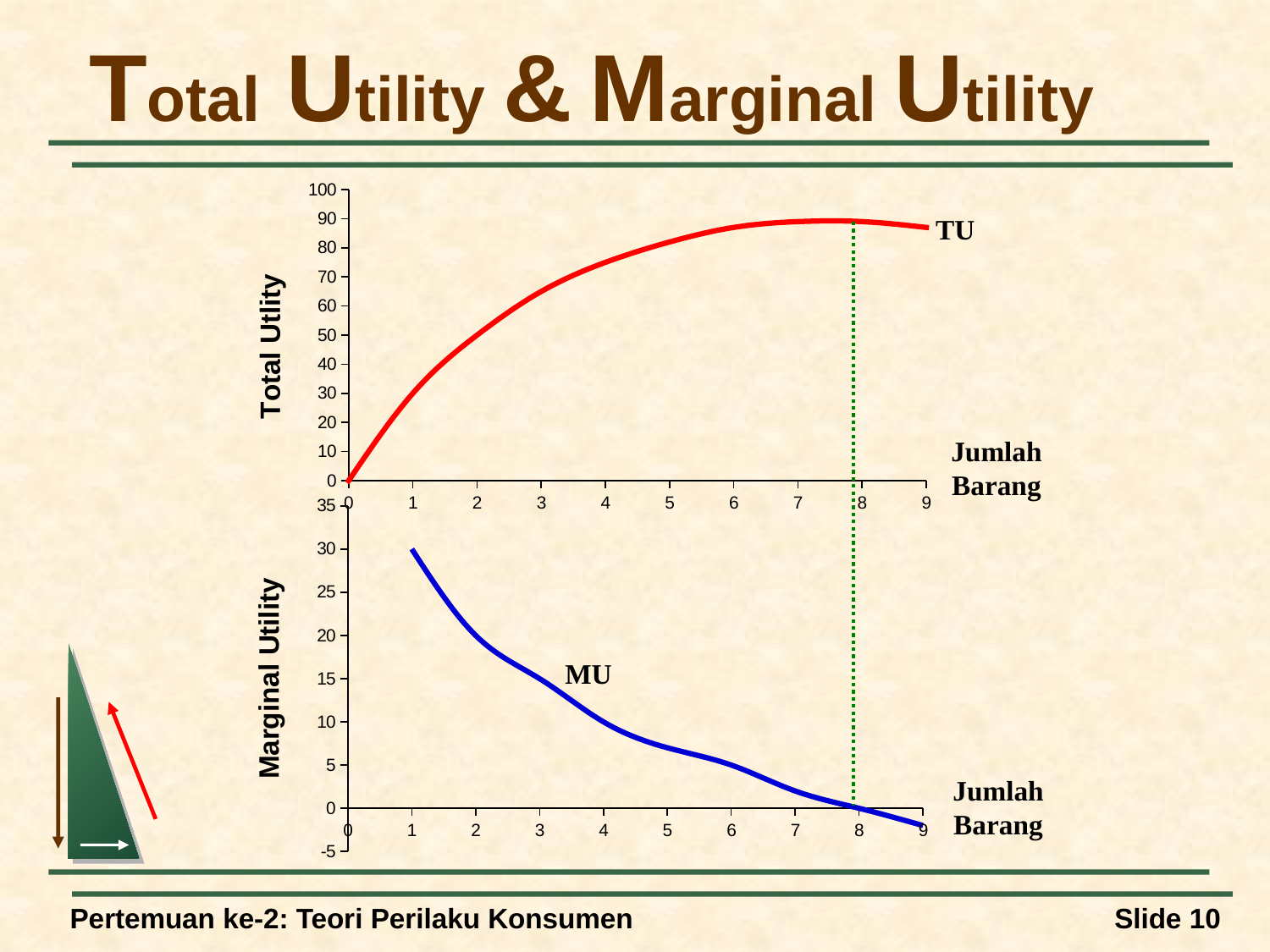
What is the label of the x axis on both charts? Jumlah Barang In the top chart (Total Utility), is the TU value at Jumlah Barang 8 greater or less than 80? greater In the top chart (Total Utility), what is the TU value at Jumlah Barang 0? 0 In the bottom chart (Marginal Utility), is the MU value at Jumlah Barang 9 greater or less than 0? less What kind of chart is the top chart (Total Utility)? line chart In the top chart (Total Utility), is the TU value at Jumlah Barang 4 greater or less than 60? greater What kind of chart is the bottom chart (Marginal Utility)? line chart What label is written next to the red curve in the top chart? TU In the bottom chart (Marginal Utility), do the MU values rise or fall as Jumlah Barang increases? fall